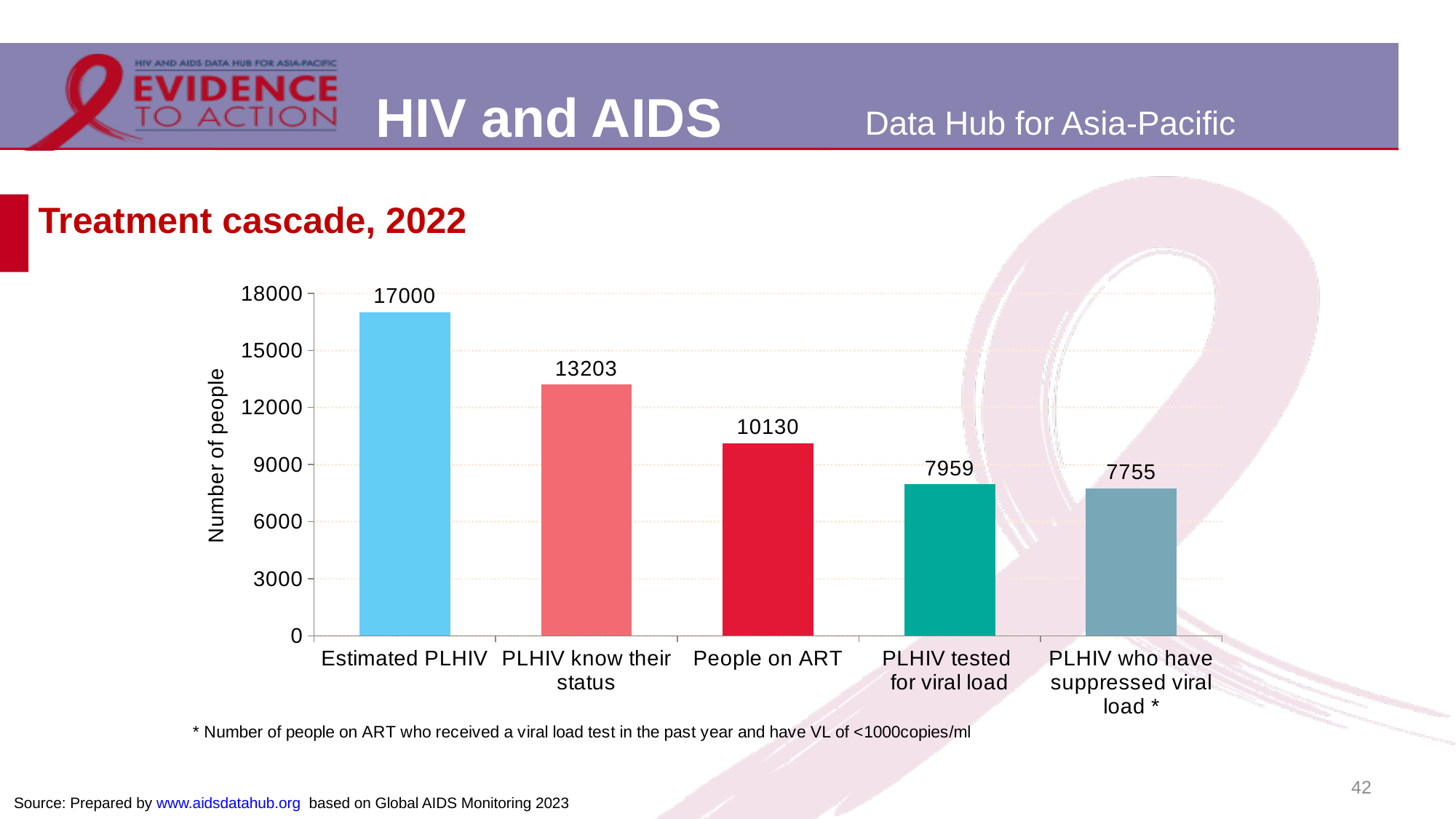
What is the value for Estimated PLHIV? 17000 Do the values rise or fall from left to right along the x axis? Fall Which category has the highest value? Estimated PLHIV Which is larger, People on ART or PLHIV tested for viral load? People on ART What is the value for PLHIV know their status? 13203 What is the difference between PLHIV tested for viral load and PLHIV who have suppressed viral load? 204 What is the difference between Estimated PLHIV and PLHIV know their status? 3797 What is the value for PLHIV tested for viral load? 7959 Which category has the lowest value? PLHIV who have suppressed viral load * What is the value for People on ART? 10130 How many categories are shown on the x axis? 5 What kind of chart is shown on the slide? Bar chart